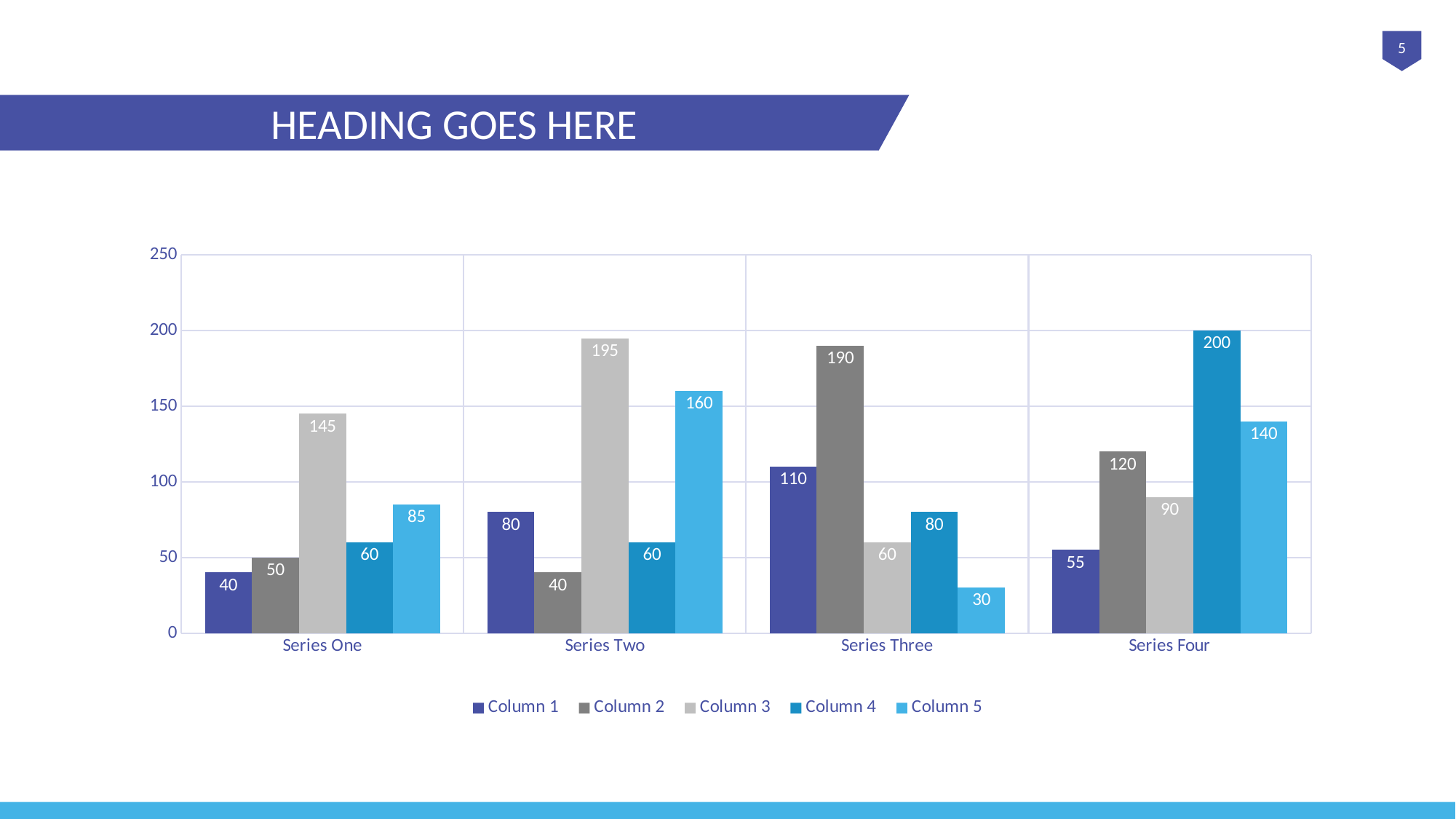
What is the value of Column 5 for Series Four? 140 How many series categories are shown on the x axis? 4 Is the value of Column 4 for Series Four greater or less than 150? greater Which is larger: Column 3 for Series One or Column 3 for Series Four? Column 3 for Series One How many entries does the legend list? 5 What is the value of Column 1 for Series Three? 110 What is the value of Column 3 for Series Two? 195 Which series has the lowest value for Column 5? Series Three Does the value of Column 1 rise or fall from Series One to Series Three? Rise Which series has the highest value for Column 4? Series Four What kind of chart is shown on the slide? Bar chart What is the difference between Column 2 for Series Three and Column 2 for Series One? 140